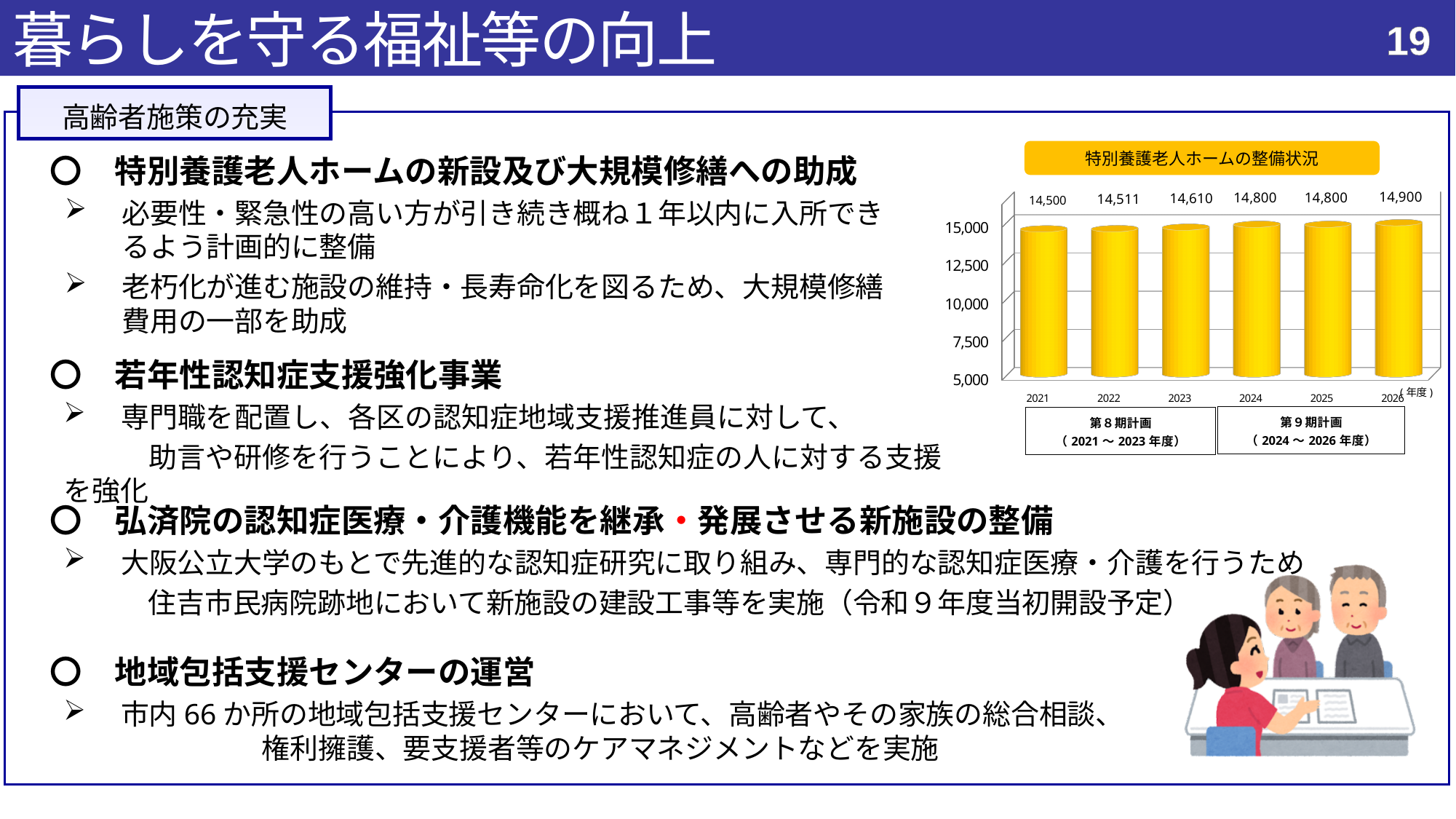
In the 特別養護老人ホームの整備状況 chart, is the value for 2022 larger or smaller than the value for 2025? smaller How many years are shown on the x axis of the 特別養護老人ホームの整備状況 chart? 6 What is the value for 2026 in the 特別養護老人ホームの整備状況 chart? 14,900 Do the values in the 特別養護老人ホームの整備状況 chart generally rise or fall from 2021 to 2026? rise What is the value for 2023 in the 特別養護老人ホームの整備状況 chart? 14,610 Which year has the lowest value in the 特別養護老人ホームの整備状況 chart? 2021 What is the difference between the values for 2024 and 2023 in the 特別養護老人ホームの整備状況 chart? 190 What is the difference between the values for 2026 and 2021 in the 特別養護老人ホームの整備状況 chart? 400 Which years does the 第９期計画 label below the 特別養護老人ホームの整備状況 chart cover? 2024～2026年度 Which year has the highest value in the 特別養護老人ホームの整備状況 chart? 2026 What is the value for 2021 in the 特別養護老人ホームの整備状況 chart? 14,500 What kind of chart is the 特別養護老人ホームの整備状況 chart? bar chart